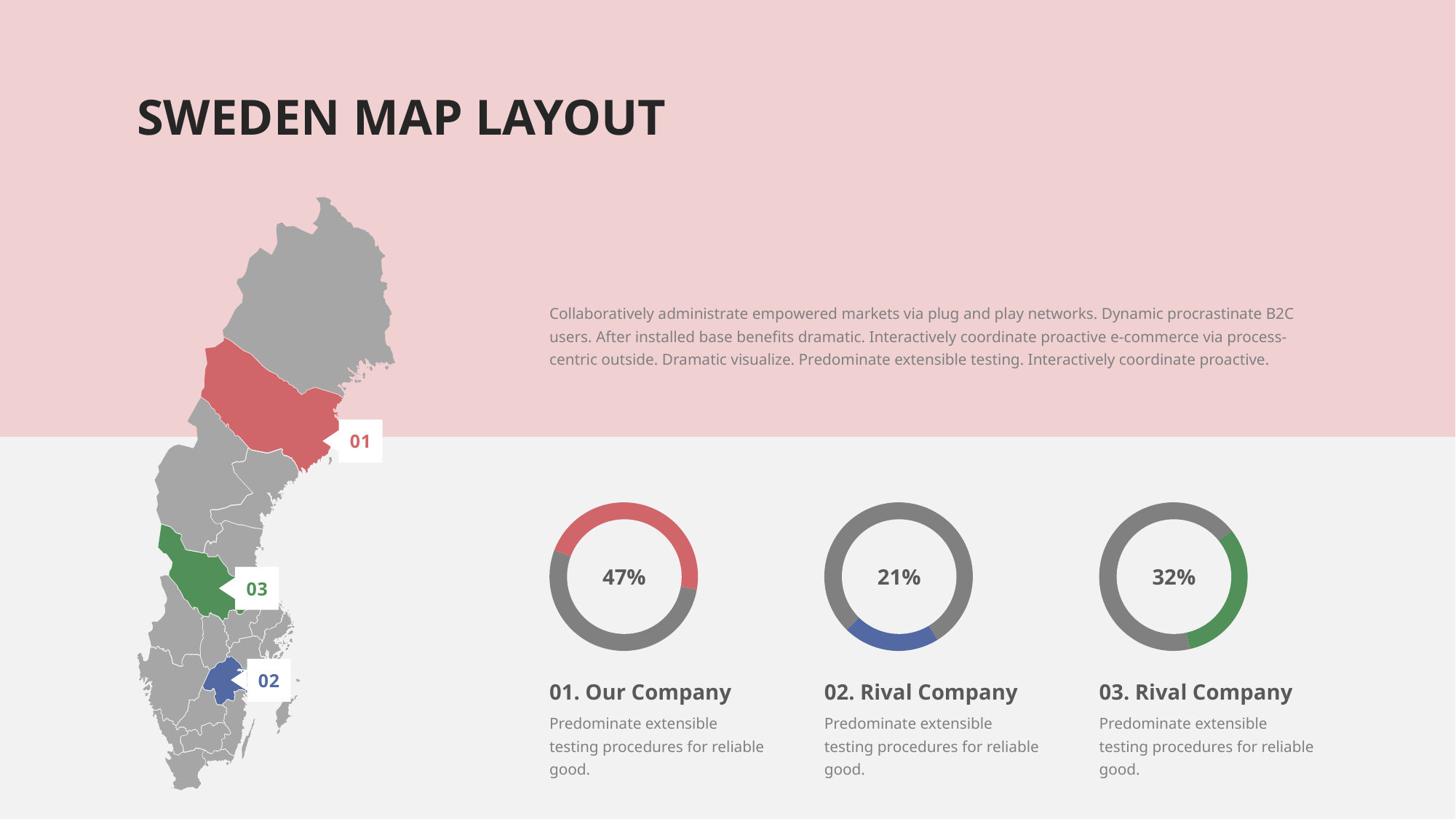
Which of the three donut charts shows the highest percentage? 01. Our Company What percentage is shown in the donut chart for 02. Rival Company? 21% What percentage is shown in the donut chart for 01. Our Company? 47% How many donut charts are shown on the slide? 3 What colour is the filled segment of the donut chart for 03. Rival Company? Green What is the difference between the percentage for 01. Our Company and the percentage for 02. Rival Company? 26% Which of the three donut charts shows the lowest percentage? 02. Rival Company What is the difference between the percentage for 03. Rival Company and the percentage for 02. Rival Company? 11% What kind of chart is used to show the percentage for 01. Our Company? Donut chart What colour is the filled segment of the donut chart for 02. Rival Company? Blue What percentage is shown in the donut chart for 03. Rival Company? 32% Which is larger, the percentage for 03. Rival Company or the percentage for 02. Rival Company? 03. Rival Company